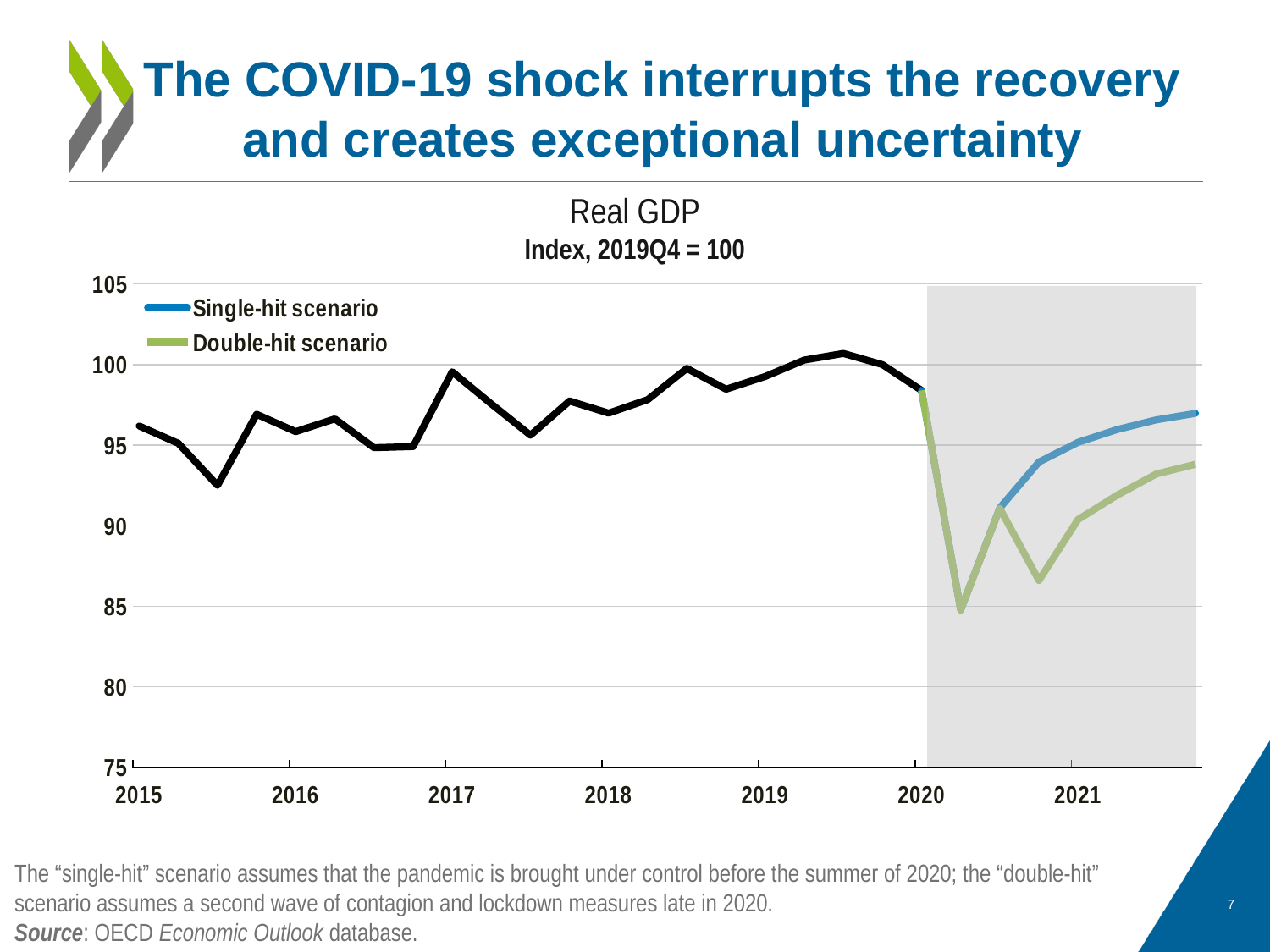
Which scenario is shown in green in the legend? Double-hit scenario Is the value of the Double-hit scenario at the end of 2021 greater or less than 95? less Is the value of the Single-hit scenario at the end of 2021 greater or less than 95? greater What is the title of the chart? Real GDP Is the value at the start of 2020 greater or less than 100? less At the end of 2021, which scenario has the higher value, Single-hit or Double-hit? Single-hit scenario What kind of chart is shown on the slide? line chart Does the Single-hit scenario line rise or fall from mid-2020 to the end of 2021? rise How many series does the legend list? 2 What is the index base stated in the chart subtitle? Index, 2019Q4 = 100